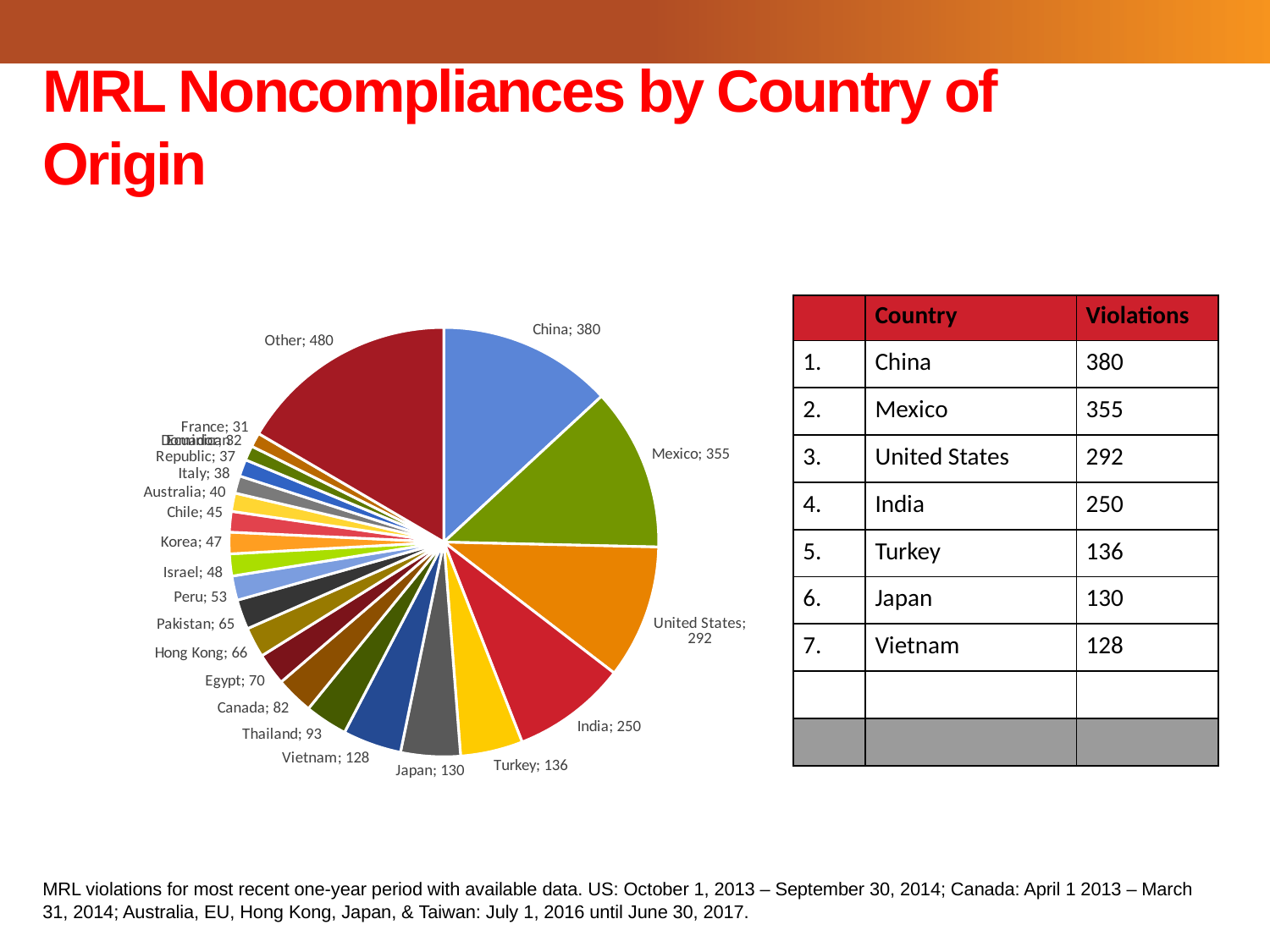
What value does the pie chart give for Vietnam? 128 What value is shown for Thailand in the pie chart? 93 Which slice of the pie chart has the largest value? Other; 480 Which individual country has the highest number of violations in the pie chart? China Which has a larger value in the pie chart, Japan or Vietnam? Japan What type of chart is shown on the slide? pie chart What value is labelled for the United States slice of the pie chart? 292 What value does the pie chart show for Mexico? 355 What is the difference between the values for India and Turkey in the pie chart? 114 How many MRL noncompliances are shown for China in the pie chart? 380 What is the difference between the values for China and Mexico in the pie chart? 25 What value is labelled for Hong Kong in the pie chart? 66